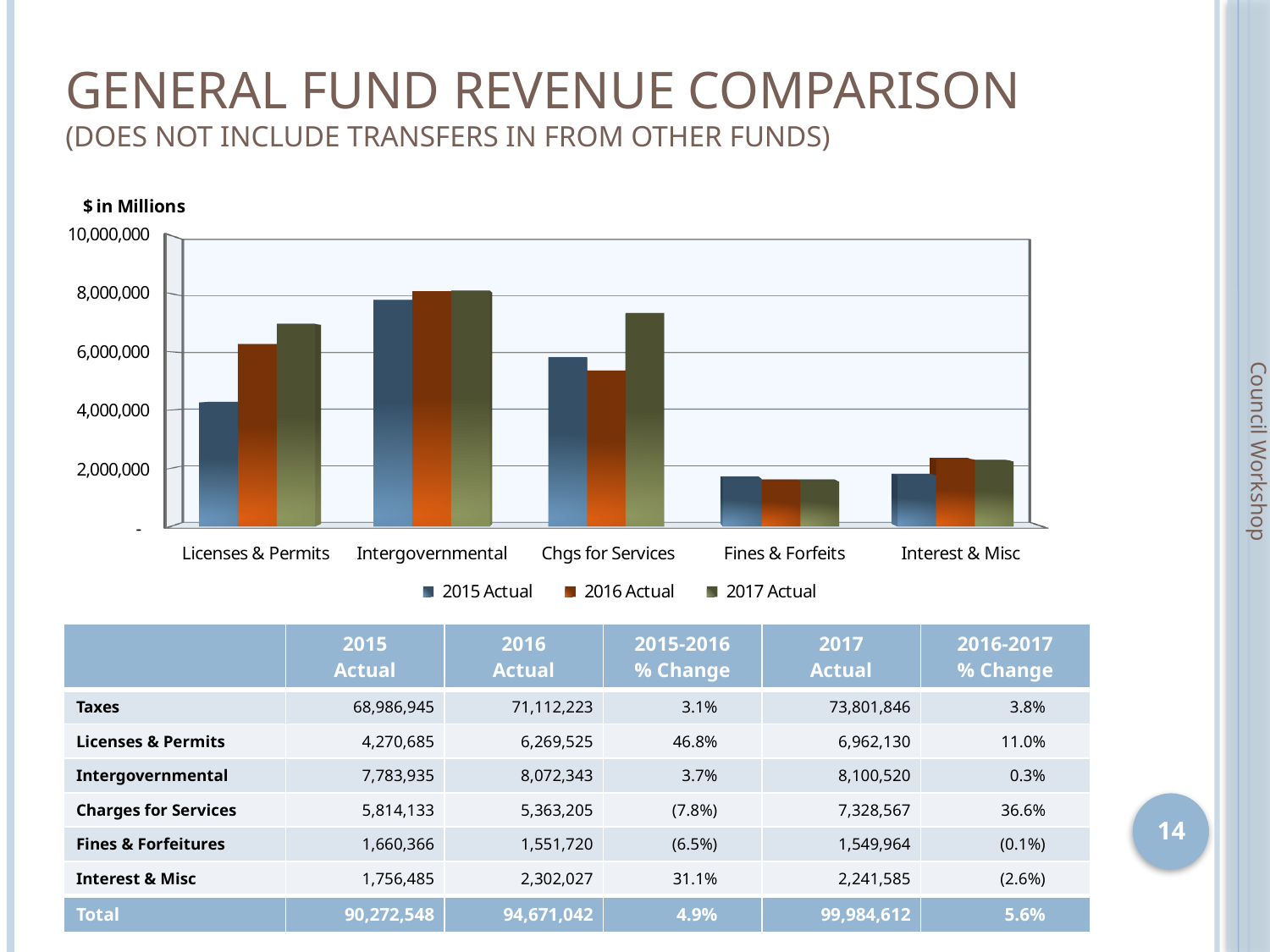
How many categories are shown on the x axis of the chart? 5 According to the table, what is the 2017 Actual value for Intergovernmental? 8,100,520 Is the 2016 Actual value for Chgs for Services greater or less than 6,000,000? less What label appears above the vertical axis of the chart? $ in Millions Using the table values, what is the difference between the 2017 Actual and 2015 Actual for Licenses & Permits? 2,691,445 Which category has the highest 2017 Actual bar in the chart? Intergovernmental Do the Licenses & Permits bars rise or fall from 2015 Actual to 2017 Actual? rise Is the 2015 Actual value for Licenses & Permits greater or less than 4,000,000? greater Is the 2017 Actual value for Fines & Forfeits greater or less than 2,000,000? less What kind of chart is shown on the slide? bar chart How many series does the chart legend list? 3 For Chgs for Services, which is larger: the 2016 Actual bar or the 2017 Actual bar? 2017 Actual